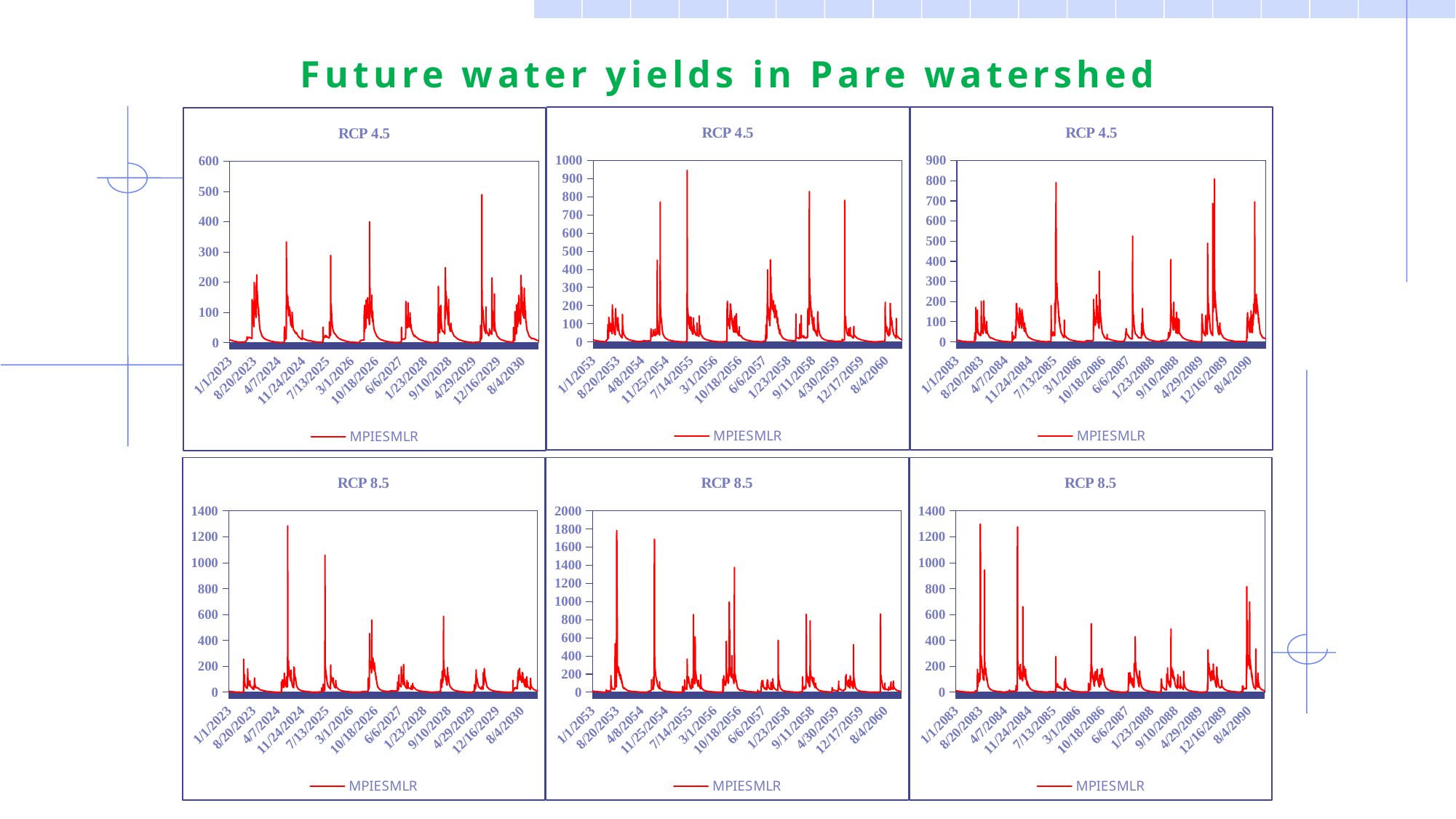
What is the name of the series shown in the legend of the top-right RCP 4.5 chart? MPIESMLR In the bottom-left RCP 8.5 chart (2023–2030), is the highest peak greater or less than 1200? greater In the top-right RCP 4.5 chart (2083–2090), is the highest peak greater or less than 700? greater In the top-middle RCP 4.5 chart (2053–2060), is the highest peak greater or less than 900? greater How many series does the legend of the bottom-middle RCP 8.5 chart list? 1 What kind of chart is the top-left chart titled RCP 4.5? line chart How many charts are shown on the slide? 6